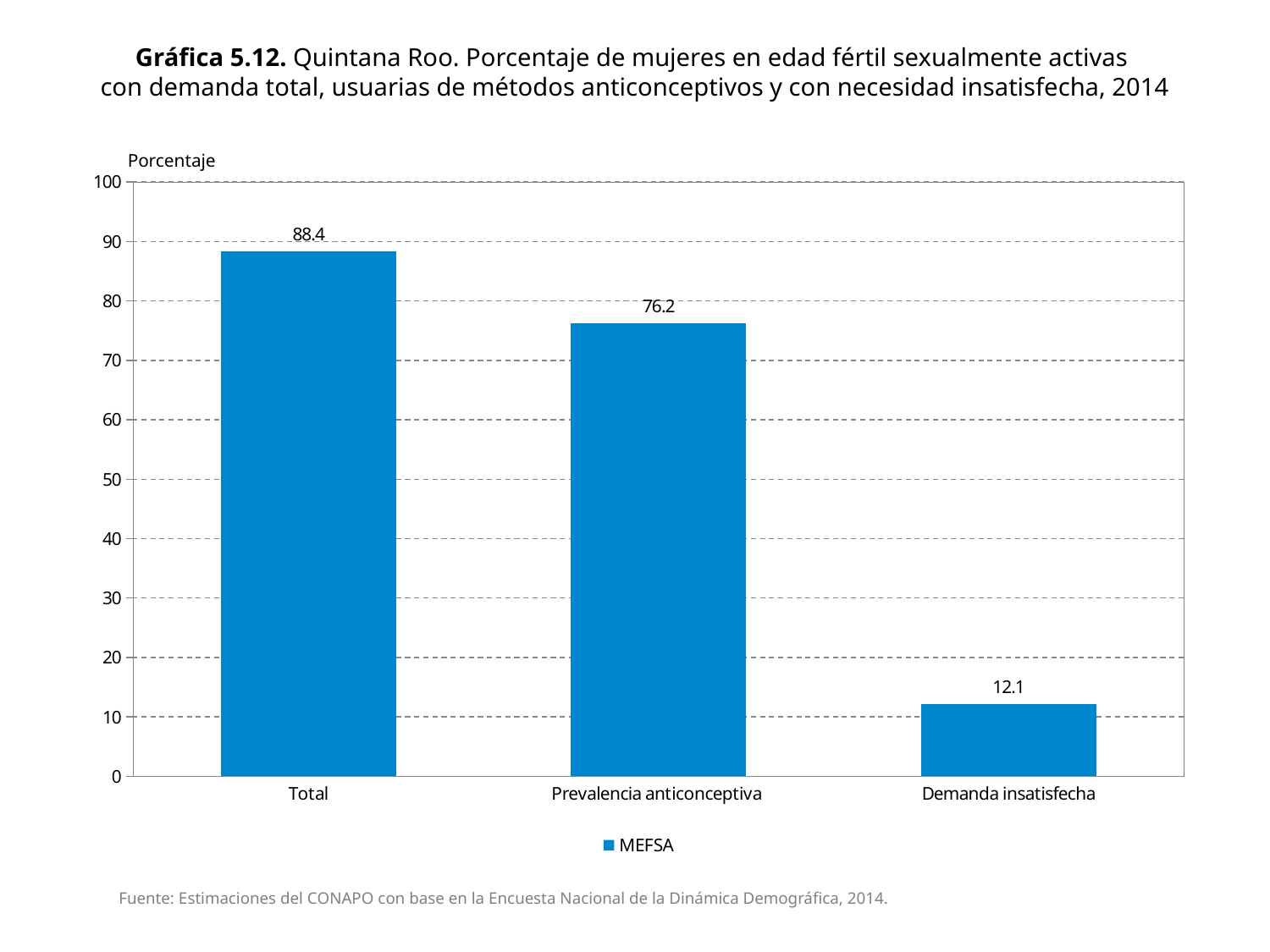
What is the value for Demanda insatisfecha? 12.1 What is the value for Prevalencia anticonceptiva? 76.2 How many categories are shown on the x axis? 3 What is the value for Total? 88.4 What is the difference between the values for Total and Prevalencia anticonceptiva? 12.2 Which is larger, the value for Prevalencia anticonceptiva or the value for Demanda insatisfecha? Prevalencia anticonceptiva Is the value for Demanda insatisfecha greater or less than 20? less Which category has the highest value? Total What is the difference between the values for Prevalencia anticonceptiva and Demanda insatisfecha? 64.1 What kind of chart is shown on the slide? bar chart Which category has the lowest value? Demanda insatisfecha How many series does the legend list? 1